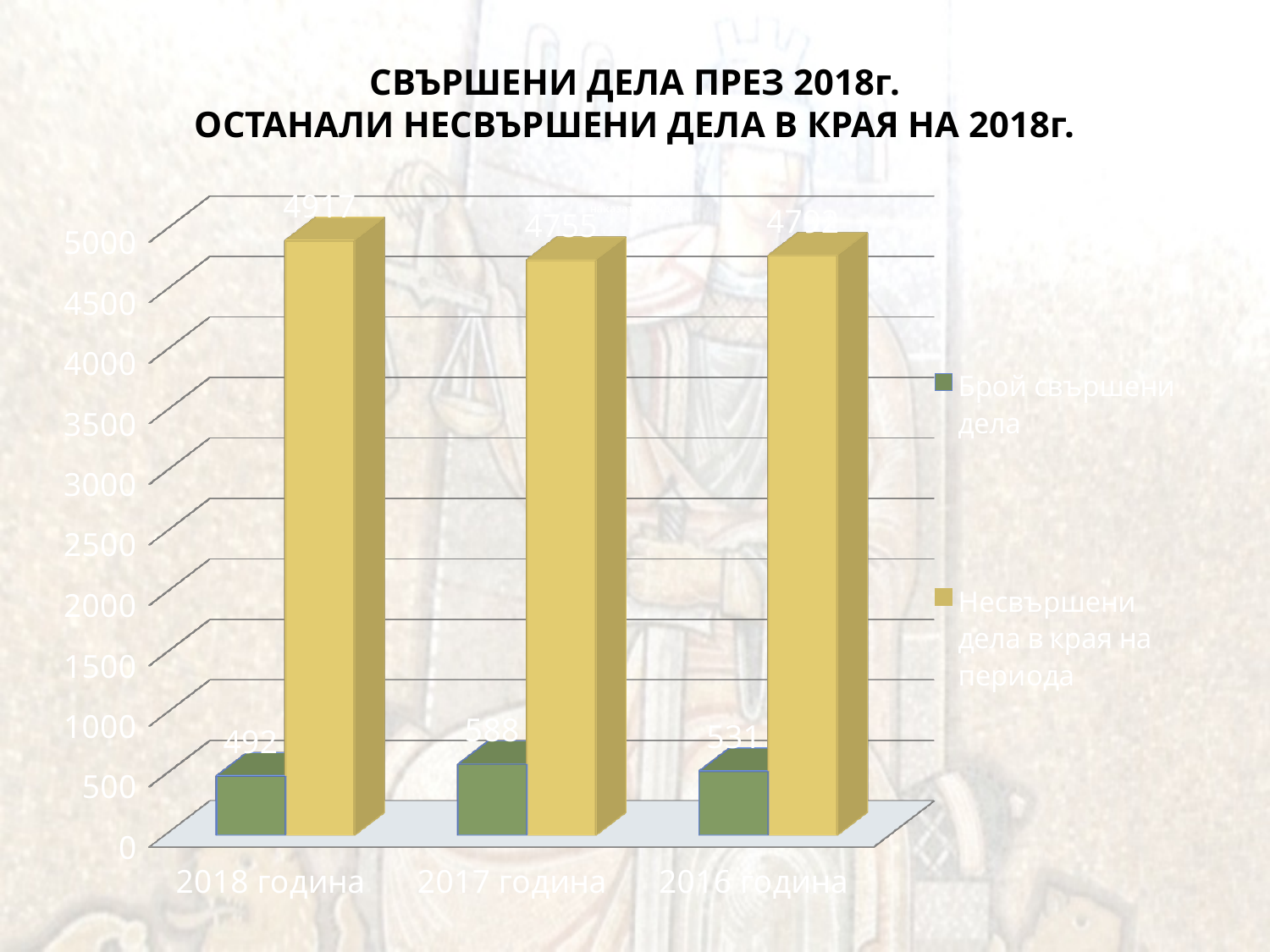
Which year has the highest value for the green series (Брой свършени дела)? 2017 година What is the value of the green bar (Брой свършени дела) for 2018 година? 492 What is the difference between the green bar values for 2017 година and 2018 година? 96 How many series does the legend list? 2 Which series is shown in yellow according to the legend? Несвършени дела в края на периода Is the yellow bar for 2016 година greater or less than 4500? greater What is the value of the green bar (Брой свършени дела) for 2017 година? 588 What is the value of the yellow bar (Несвършени дела в края на периода) for 2018 година? 4917 What is the value of the yellow bar (Несвършени дела в края на периода) for 2017 година? 4755 What type of chart is shown on the slide? Bar chart What is the value of the green bar (Брой свършени дела) for 2016 година? 531 How many year categories are shown on the x axis? 3